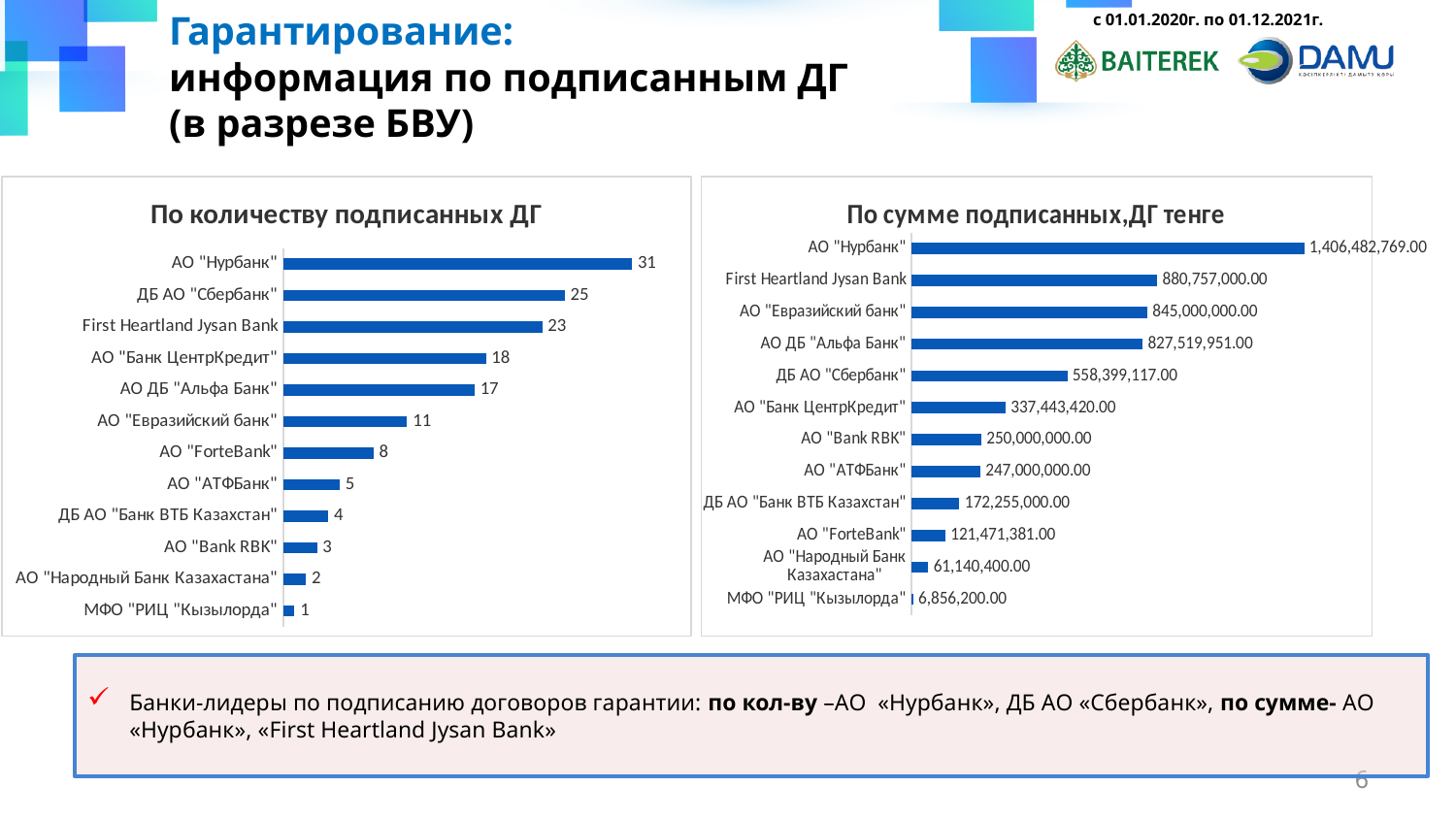
In the chart titled "По количеству подписанных ДГ", what is the value for ДБ АО "Сбербанк"? 25 In the chart titled "По сумме подписанных,ДГ тенге", which category has the lowest value? МФО "РИЦ "Кызылорда" What kind of chart is the chart titled "По сумме подписанных,ДГ тенге"? Bar chart In the chart titled "По сумме подписанных,ДГ тенге", what is the value for АО "Bank RBK"? 250,000,000.00 What is the title of the chart on the left side of the slide? По количеству подписанных ДГ In the chart titled "По количеству подписанных ДГ", which category has the lowest value? МФО "РИЦ "Кызылорда" In the chart titled "По количеству подписанных ДГ", how many categories are shown? 12 In the chart titled "По количеству подписанных ДГ", what is the difference between the values for АО "Банк ЦентрКредит" and АО "Евразийский банк"? 7 In the chart titled "По сумме подписанных,ДГ тенге", what is the value for First Heartland Jysan Bank? 880,757,000.00 In the chart titled "По количеству подписанных ДГ", which category has the highest value? АО "Нурбанк" In the chart titled "По сумме подписанных,ДГ тенге", which is larger: the value for АО "Евразийский банк" or the value for ДБ АО "Сбербанк"? АО "Евразийский банк" In the chart titled "По сумме подписанных,ДГ тенге", what is the difference between the values for АО "Bank RBK" and АО "АТФБанк"? 3,000,000.00